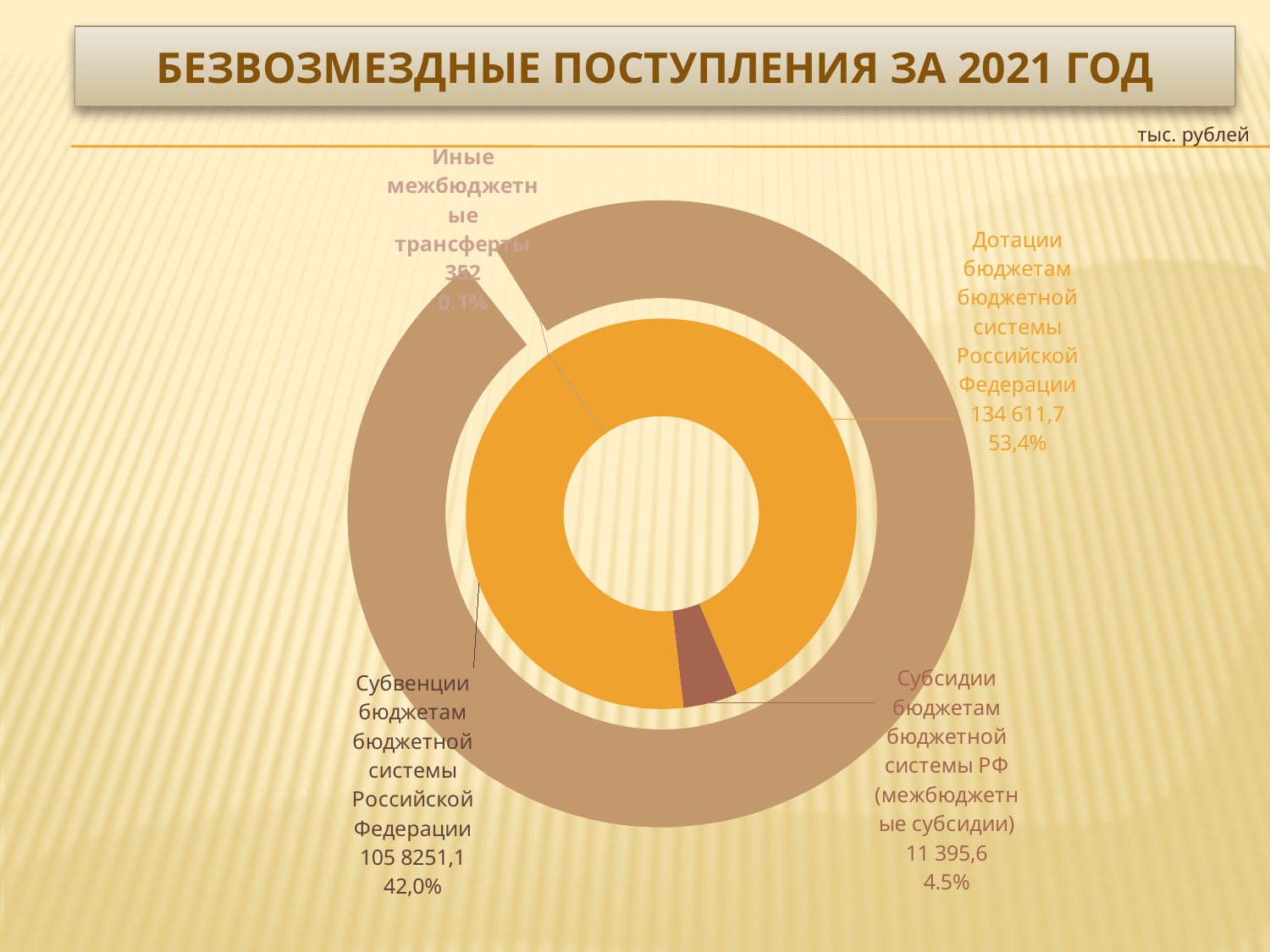
What percentage is shown for Субвенции бюджетам бюджетной системы Российской Федерации? 42,0% How many categories are shown in the chart? 4 What is the title of the chart on the slide? БЕЗВОЗМЕЗДНЫЕ ПОСТУПЛЕНИЯ ЗА 2021 ГОД What percentage is shown for Иные межбюджетные трансферты? 0.1% Which category has the largest share of the chart? Дотации бюджетам бюджетной системы Российской Федерации What is the value for Иные межбюджетные трансферты? 352 What kind of chart is shown on the slide? Doughnut chart What is the value for Дотации бюджетам бюджетной системы Российской Федерации? 134 611,7 Which category has the smallest share of the chart? Иные межбюджетные трансферты What share of the chart does Дотации бюджетам бюджетной системы Российской Федерации represent? 53,4% What is the value for Субсидии бюджетам бюджетной системы РФ (межбюджетные субсидии)? 11 395,6